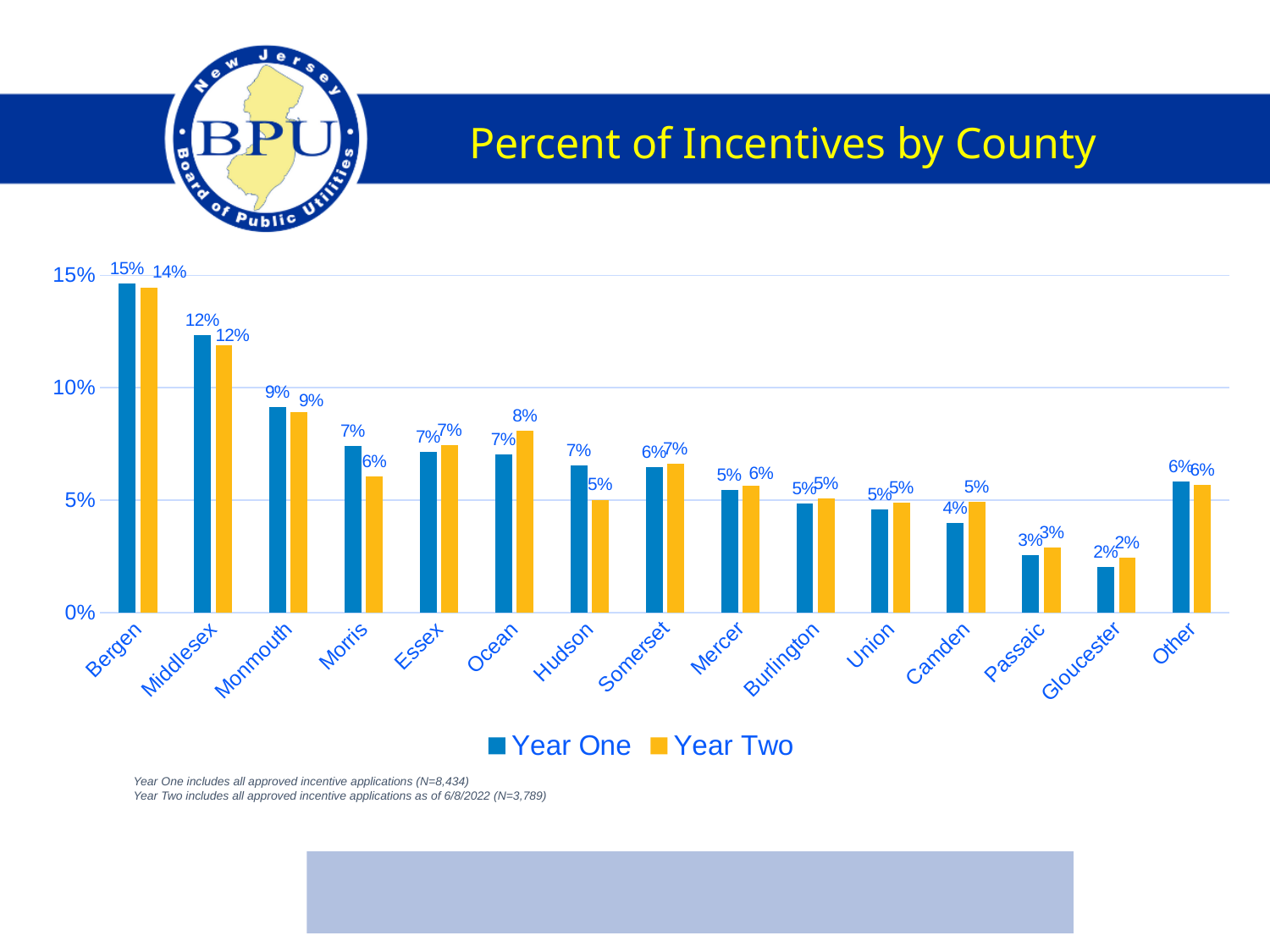
Which county has the highest Year One percentage? Bergen How many counties (categories) are shown on the x axis? 15 Which county has the lowest Year Two percentage? Gloucester What is the Year One value for Bergen? 15% What kind of chart is shown on the slide? Bar chart What is the Year One value for Camden? 4% What is the difference between the Year One and Year Two values for Hudson? 2% What is the Year Two value for Hudson? 5% Which is larger for Morris: the Year One value or the Year Two value? Year One How many series does the legend list? 2 What is the Year Two value for Ocean? 8% What is the title of the chart? Percent of Incentives by County